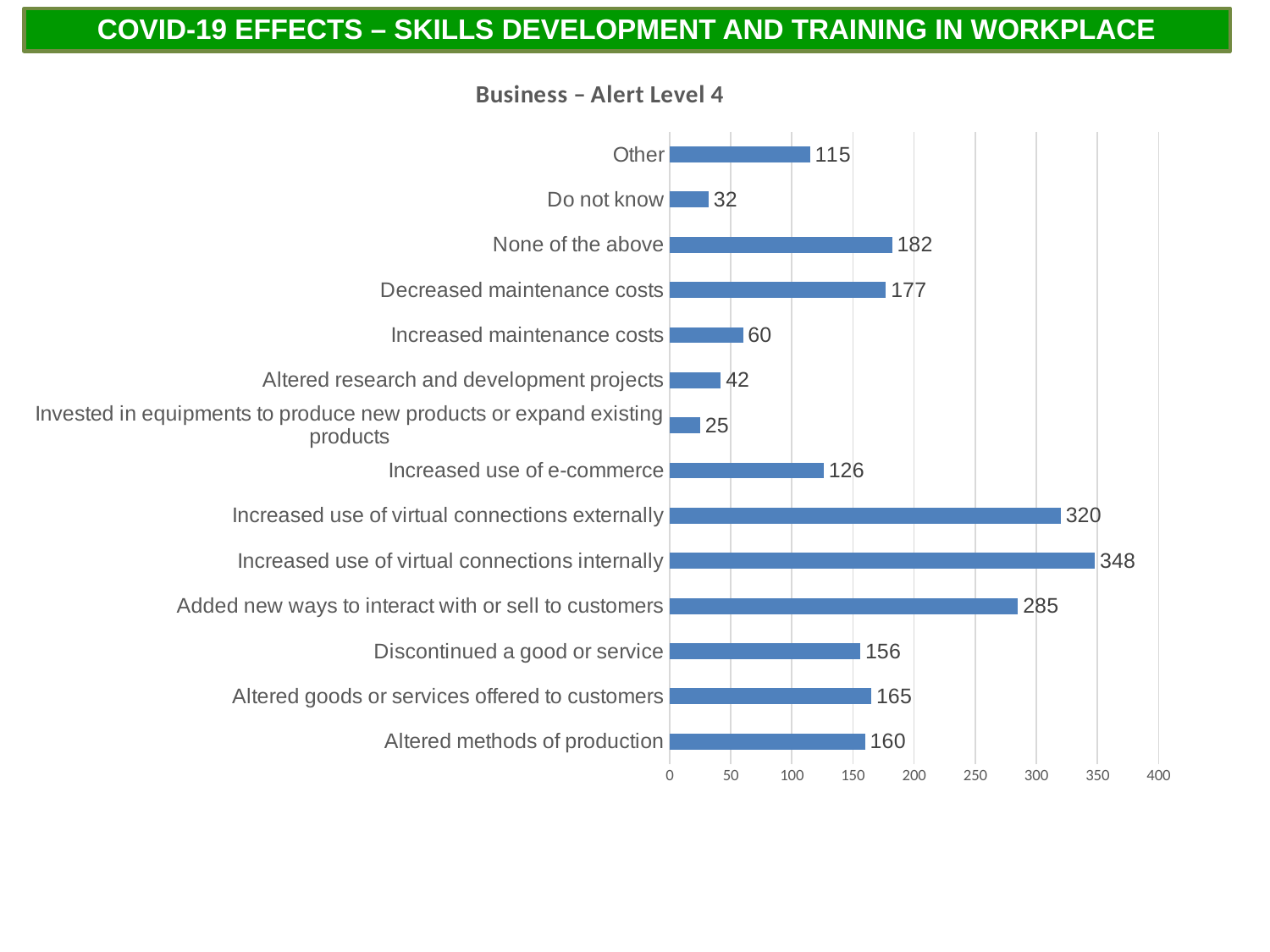
What is the value for Increased use of virtual connections internally? 348 Which is larger: Altered goods or services offered to customers or Altered methods of production? Altered goods or services offered to customers Is the value for Increased use of e-commerce greater or less than 100? greater Which category has the highest value? Increased use of virtual connections internally How many categories are shown in the chart? 14 What kind of chart is shown on the slide? Bar chart What is the difference between None of the above and Other? 67 What is the value for Do not know? 32 What is the value for Decreased maintenance costs? 177 Which category has the lowest value? Invested in equipments to produce new products or expand existing products What is the difference between Increased use of virtual connections externally and Added new ways to interact with or sell to customers? 35 What is the title of the chart? Business – Alert Level 4